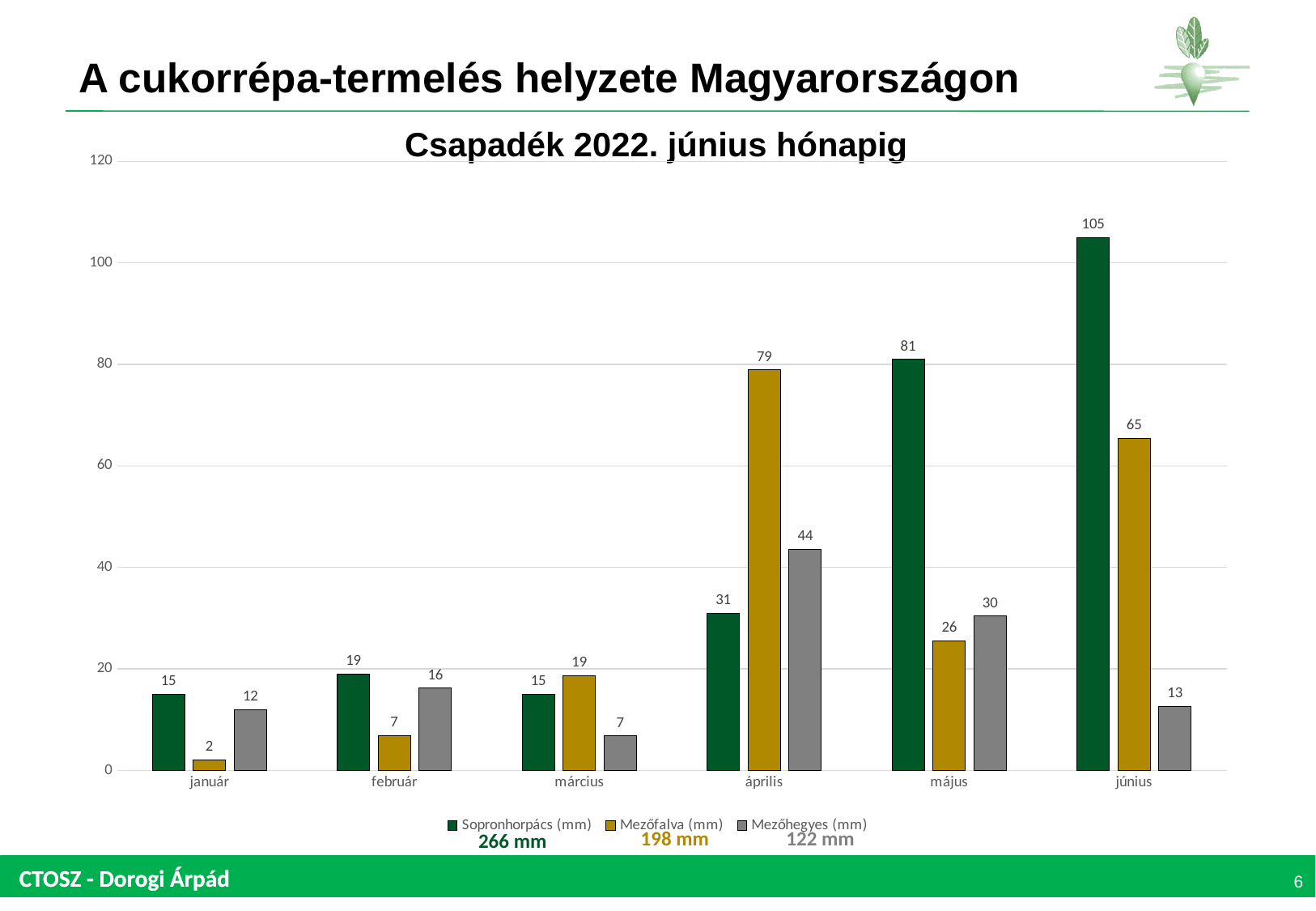
In április, which is larger: Mezőfalva (mm) or Sopronhorpács (mm)? Mezőfalva (mm) What is the value for Mezőfalva (mm) in április? 79 Which month has the highest value for Sopronhorpács (mm)? június What is the value for Sopronhorpács (mm) in június? 105 What is the value for Mezőhegyes (mm) in május? 30 What is the title of the chart? Csapadék 2022. június hónapig What kind of chart is shown on the slide? bar chart Is the value for Sopronhorpács (mm) in június greater or less than 100? greater How many months are shown on the x axis? 6 What is the difference between the Sopronhorpács (mm) and Mezőfalva (mm) values in május? 55 Which month has the lowest value for Mezőfalva (mm)? január How many series does the legend list? 3